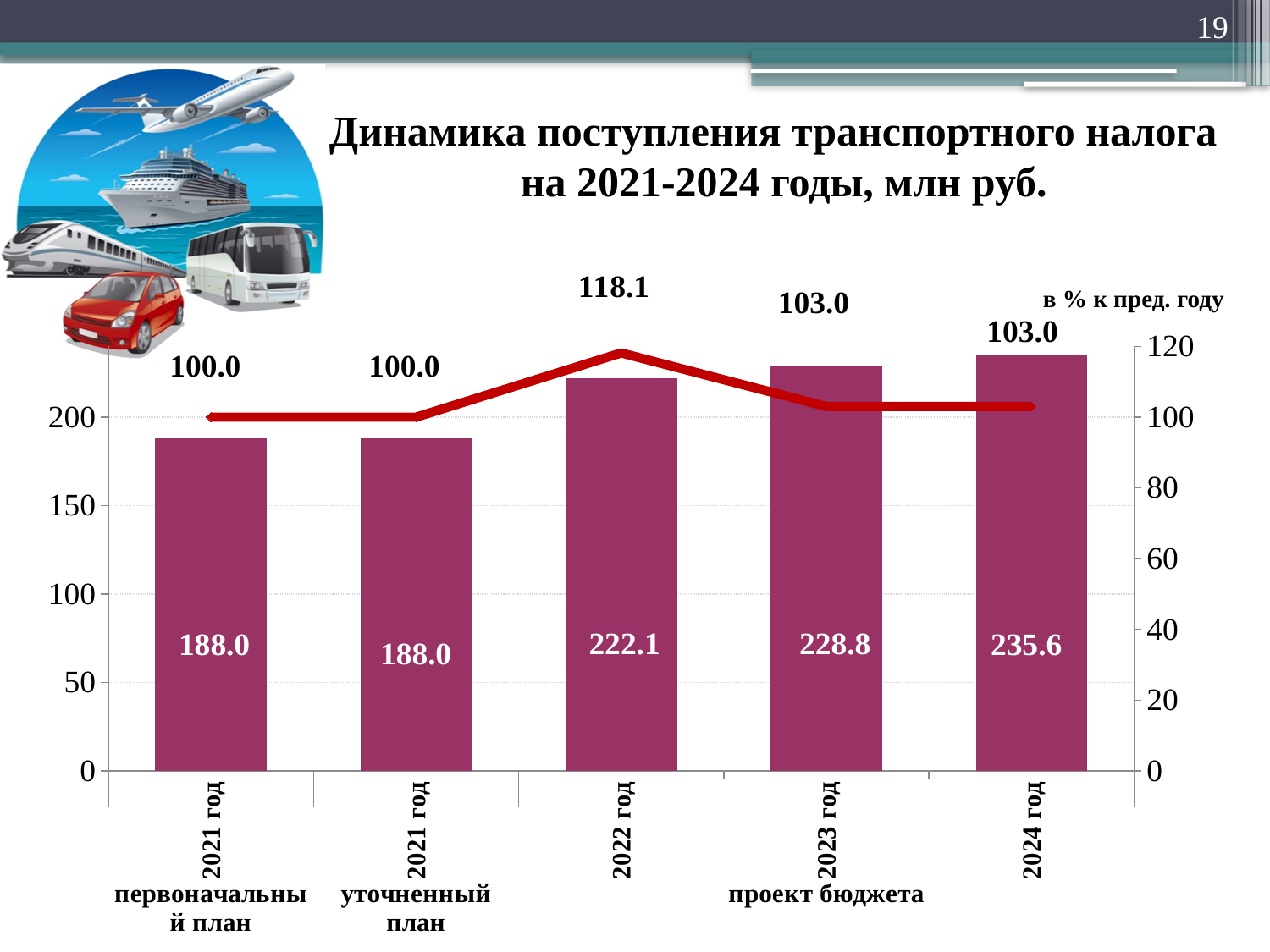
What is the difference between the bar values for 2024 год and 2023 год? 6.8 What is the value of the line series (в % к пред. году) for 2023 год? 103.0 What is the value shown for 2022 год in the bar series? 222.1 Which year has the highest bar value? 2024 год What is the difference between the bar values for 2022 год and 2021 год (уточненный план)? 34.1 What is the value of the line series (в % к пред. году) for 2022 год? 118.1 Do the bar values rise or fall from 2022 год to 2024 год? rise Which year has the highest value in the line series (в % к пред. году)? 2022 год How many bars are plotted on the chart? 5 What is the transport tax revenue value shown for 2024 год? 235.6 Which is larger, the bar value for 2023 год or for 2022 год? 2023 год What is the title of the chart? Динамика поступления транспортного налога на 2021-2024 годы, млн руб.